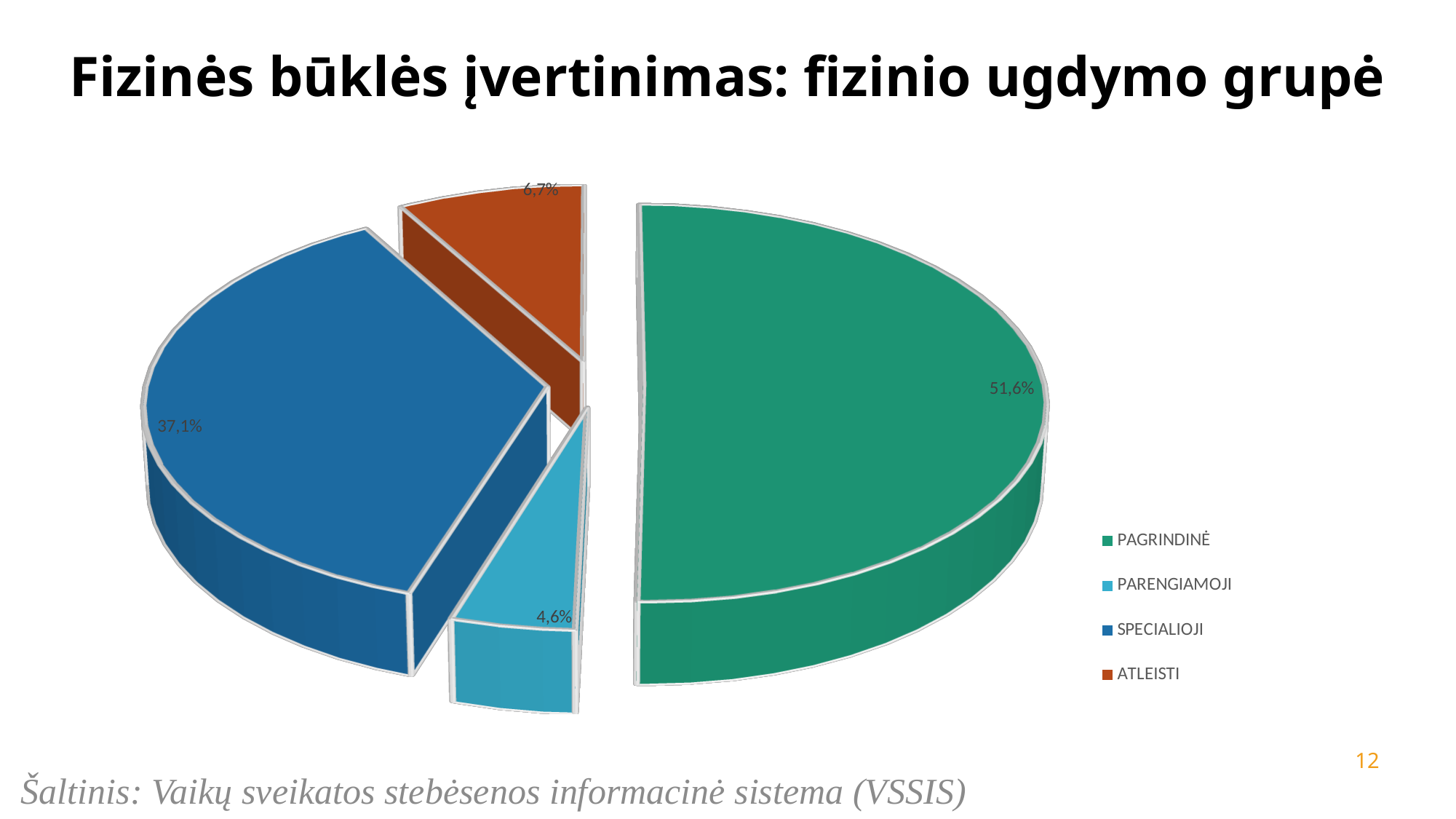
How many categories does the pie chart show? 4 What is the difference in percentage points between ATLEISTI and PARENGIAMOJI? 2,1% What share of the pie does ATLEISTI hold? 6,7% What share of the pie does PARENGIAMOJI hold? 4,6% What share of the pie does SPECIALIOJI hold? 37,1% What is the title of the slide containing the chart? Fizinės būklės įvertinimas: fizinio ugdymo grupė Which category has the largest slice of the pie? PAGRINDINĖ Which is larger, the share for ATLEISTI or the share for PARENGIAMOJI? ATLEISTI What is the difference in percentage points between PAGRINDINĖ and SPECIALIOJI? 14,5% What share of the pie does PAGRINDINĖ hold? 51,6% What type of chart is shown on the slide? Pie chart Which category has the smallest slice of the pie? PARENGIAMOJI